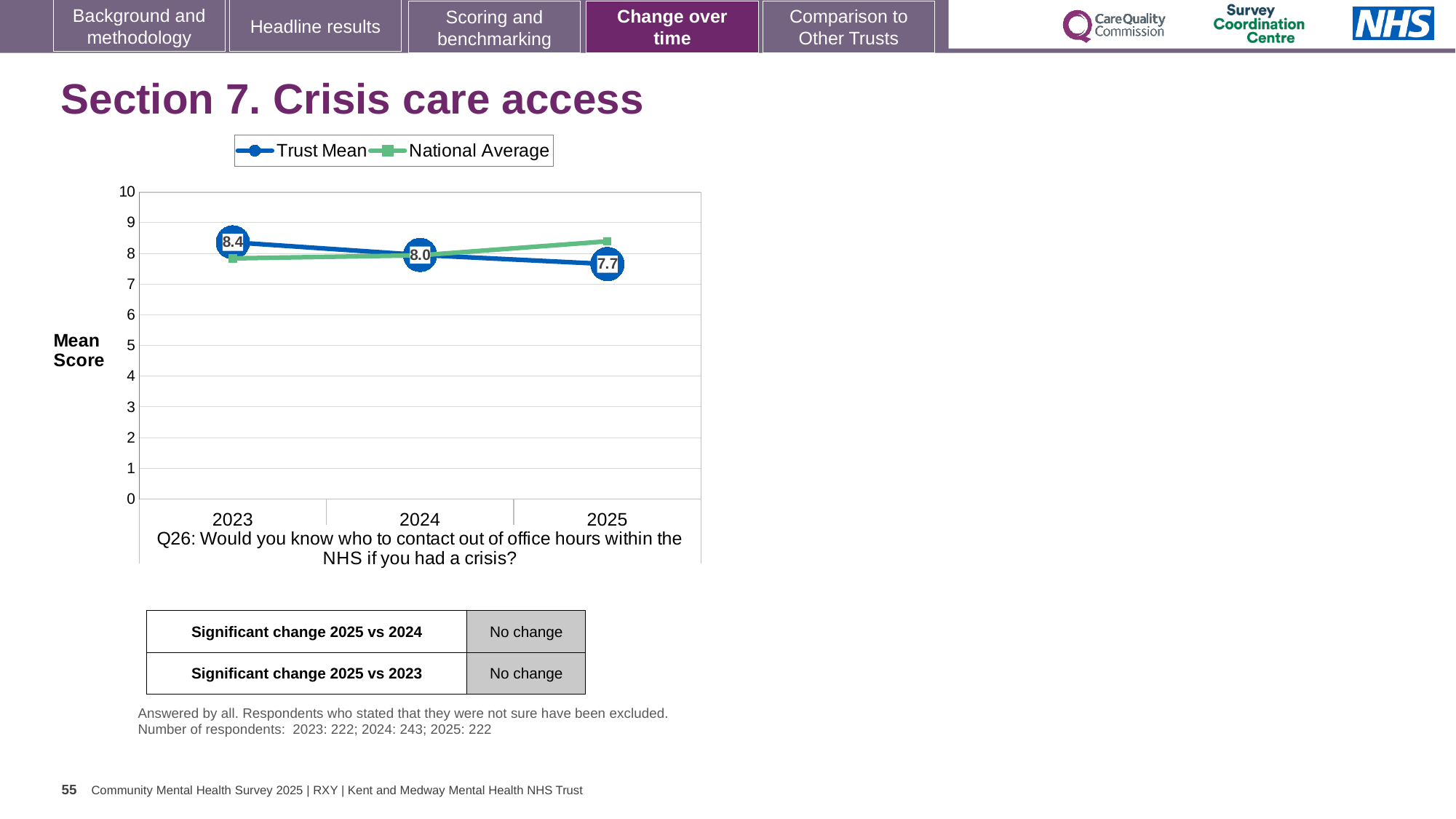
What is the label on the y axis? Mean Score Is the National Average for 2025 greater or less than 8? greater How many years are plotted on the x axis? 3 Does the Trust Mean rise or fall from 2023 to 2025? fall What is the Trust Mean score for 2025? 7.7 In which year is the Trust Mean lowest? 2025 What kind of chart is shown? line chart In 2025, which is higher: the Trust Mean or the National Average? National Average What is the difference between the Trust Mean in 2023 and in 2025? 0.7 What is the Trust Mean score for 2023? 8.4 In which year is the Trust Mean highest? 2023 How many series does the legend list? 2